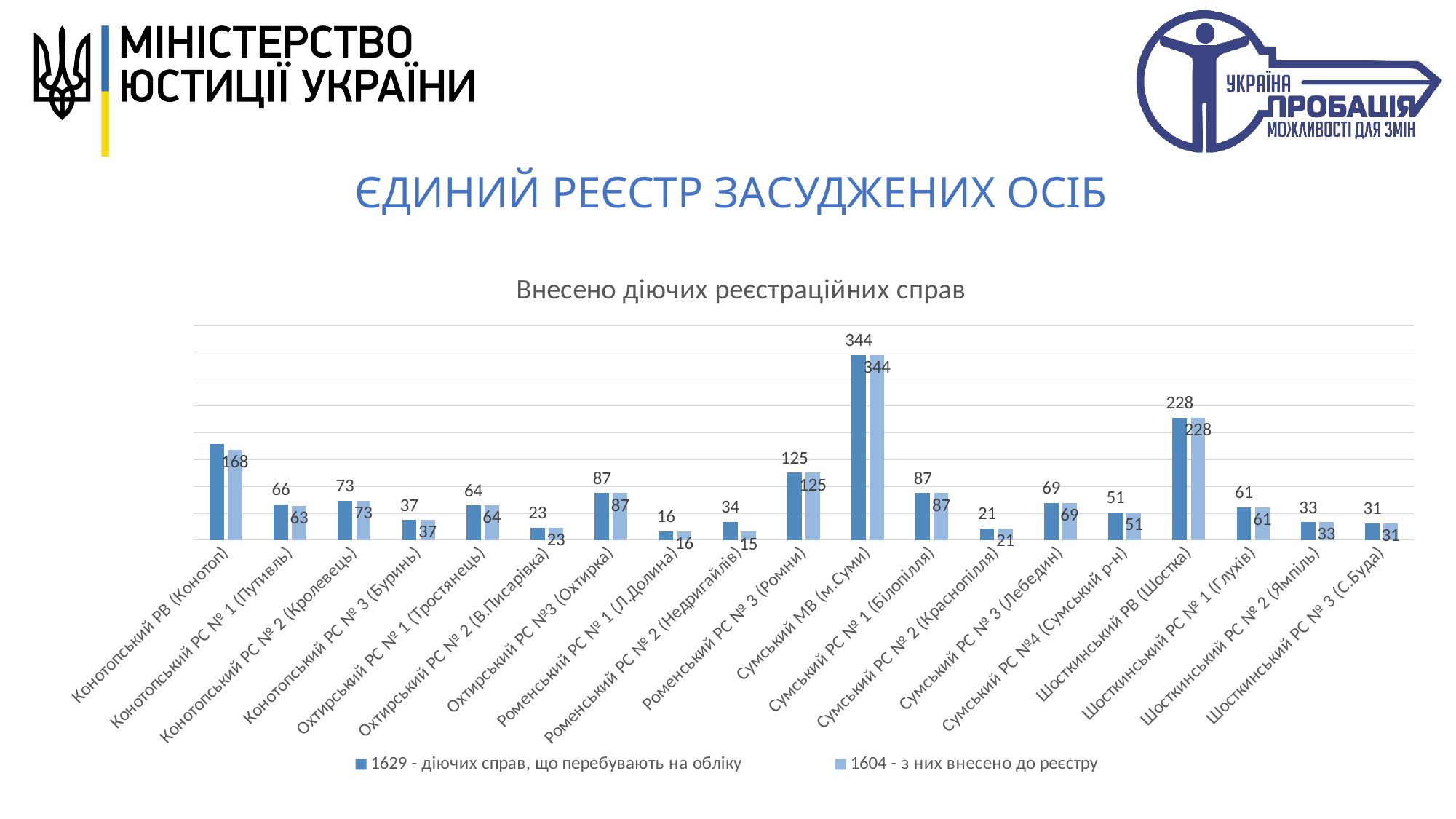
What is the value of '1604 - з них внесено до реєстру' for Роменський РС № 2 (Недригайлів)? 15 Which category has the lowest value for '1604 - з них внесено до реєстру'? Роменський РС № 2 (Недригайлів) How many series does the legend list? 2 What is the value of '1604 - з них внесено до реєстру' for Конотопський РВ (Конотоп)? 168 Which is larger: the '1629 - діючих справ, що перебувають на обліку' value for Шосткинський РВ (Шостка) or for Роменський РС № 3 (Ромни)? Шосткинський РВ (Шостка) What is the value of '1629 - діючих справ, що перебувають на обліку' for Конотопський РС № 1 (Путивль)? 66 What is the difference between the two series for Роменський РС № 2 (Недригайлів)? 19 What kind of chart is shown on the slide? bar chart Which category has the highest value for '1629 - діючих справ, що перебувають на обліку'? Сумський МВ (м.Суми) What is the title of the chart? Внесено діючих реєстраційних справ What is the value of '1629 - діючих справ, що перебувають на обліку' for Роменський РС № 2 (Недригайлів)? 34 How many categories are shown on the x axis of the chart? 19